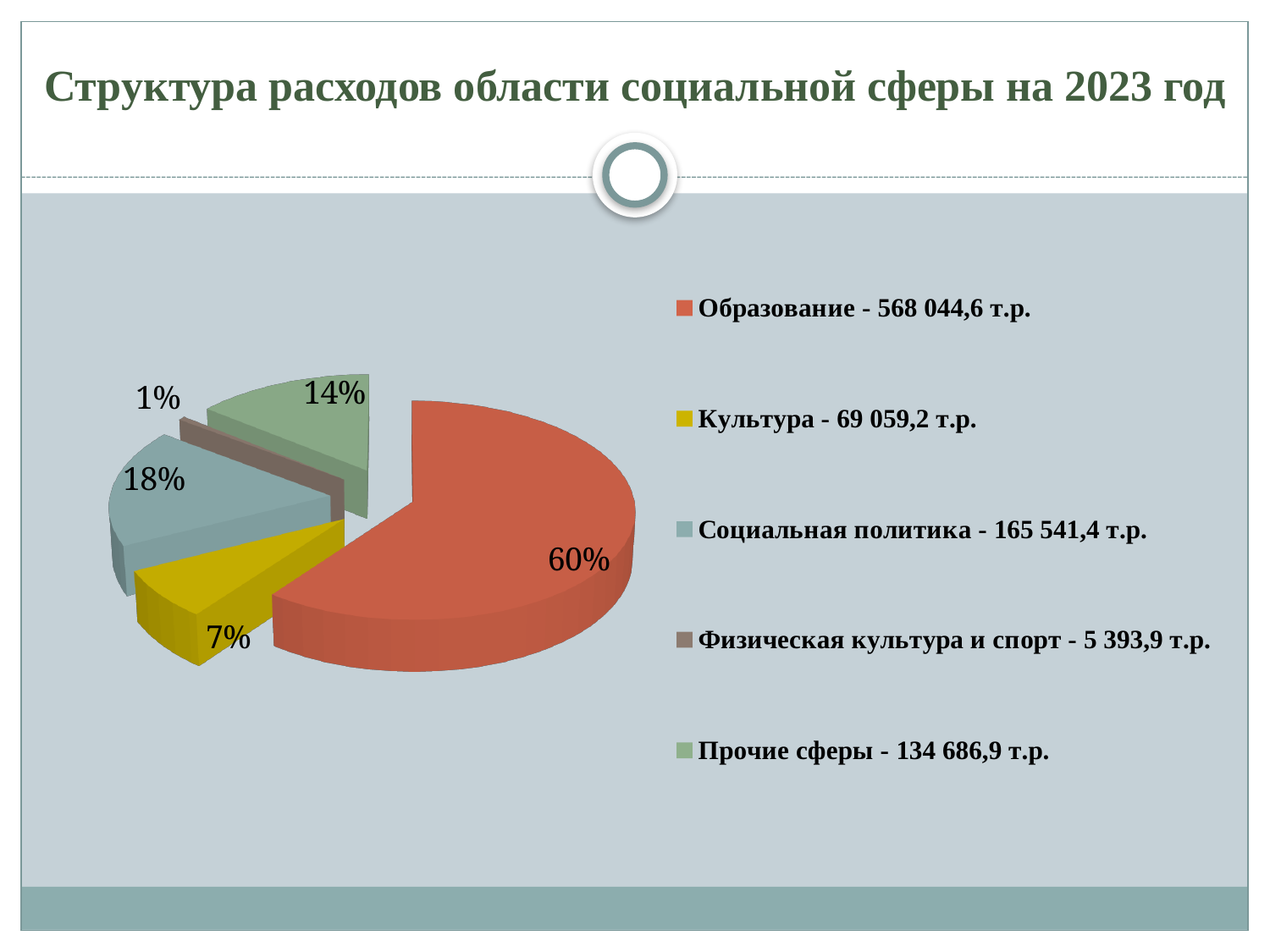
Which category has the largest slice of the pie? Образование What share of the pie does Образование take? 60% Which is larger, the share for Социальная политика or the share for Прочие сферы? Социальная политика Which category has the smallest slice of the pie? Физическая культура и спорт What share of the pie does Физическая культура и спорт take? 1% How many slices does the pie chart have? 5 What amount does the legend give for Культура? 69 059,2 т.р. What share of the pie does Прочие сферы take? 14% What kind of chart is shown on the slide? pie chart What is the difference in percentage points between the Образование slice and the Социальная политика slice? 42